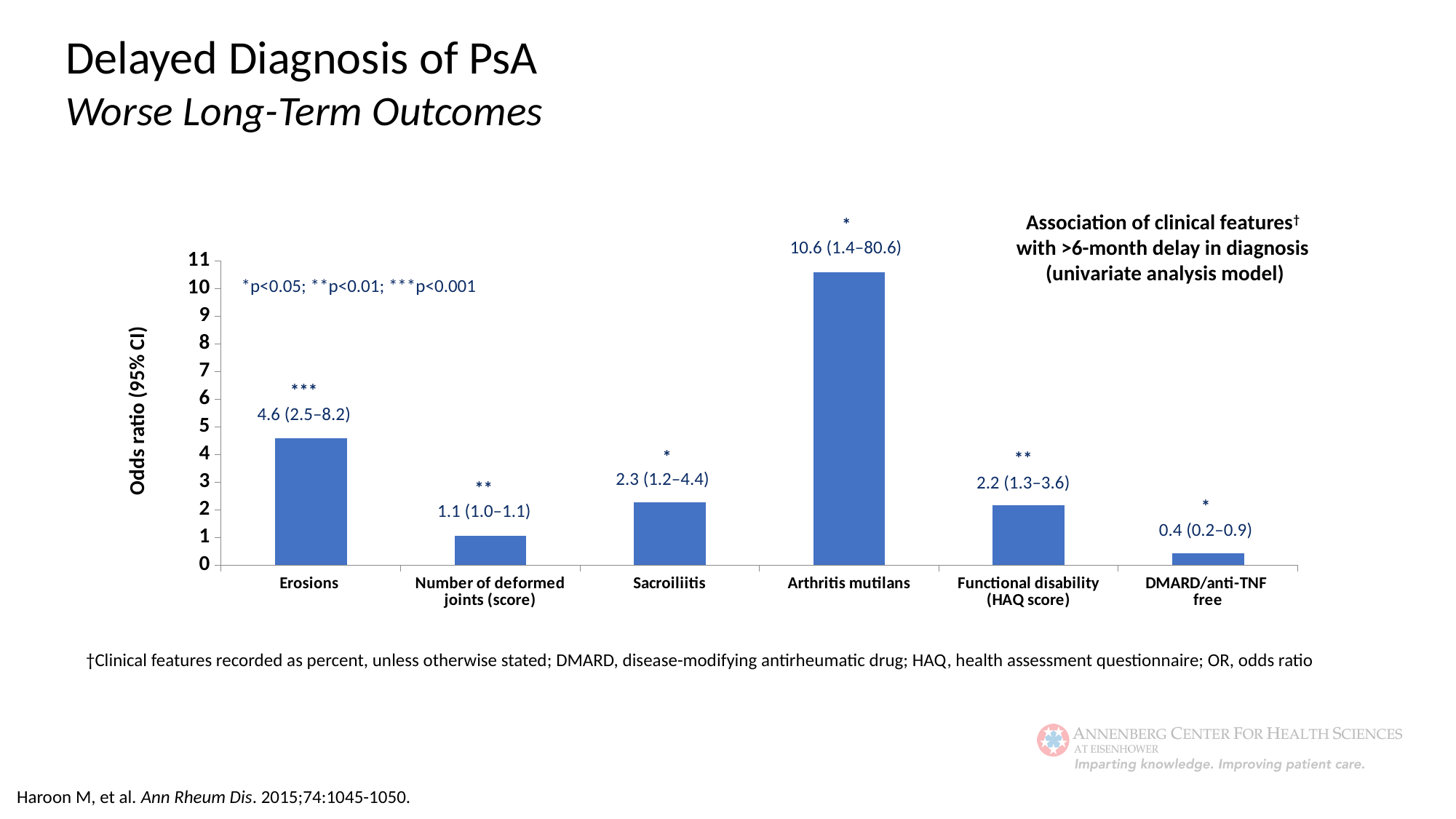
What is the 95% CI shown for Functional disability (HAQ score)? 1.3–3.6 Is the odds ratio for Erosions greater or less than 4? greater What kind of chart is shown on the slide? Bar chart What is the label of the y axis? Odds ratio (95% CI) Which has a larger odds ratio, Sacroiliitis or Number of deformed joints (score)? Sacroiliitis Which clinical feature has the lowest odds ratio? DMARD/anti-TNF free What is the odds ratio for DMARD/anti-TNF free? 0.4 Which clinical feature has the highest odds ratio? Arthritis mutilans What is the difference between the odds ratios for Arthritis mutilans and Erosions? 6.0 How many clinical features are plotted on the chart? 6 What is the odds ratio for Erosions? 4.6 What is the odds ratio for Arthritis mutilans? 10.6